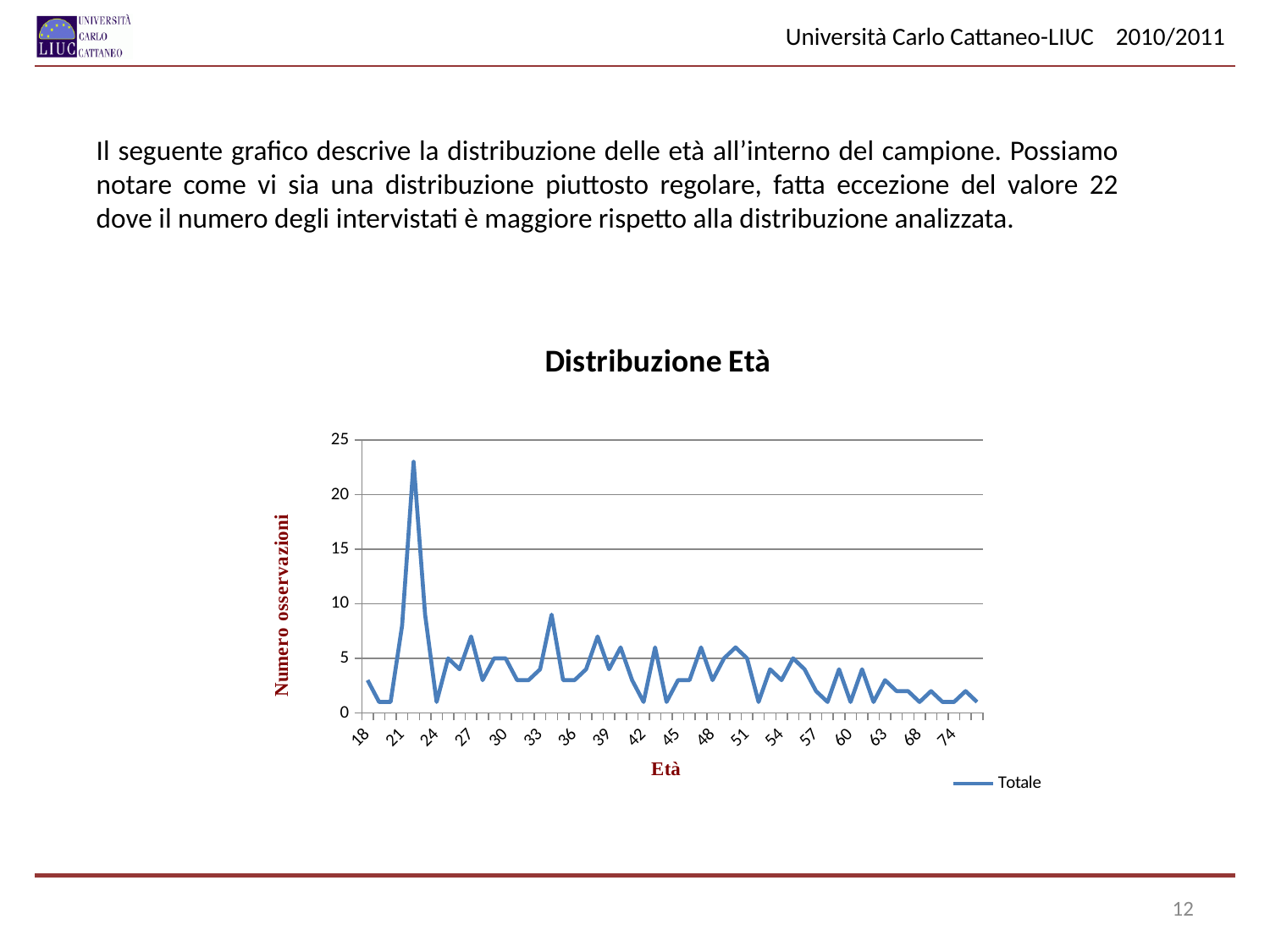
Is the value for age 24 in the "Distribuzione Età" chart greater or less than 5? less How many series does the legend of the "Distribuzione Età" chart list? 1 How many age labels are shown on the x axis of the "Distribuzione Età" chart? 18 At which age does the "Distribuzione Età" chart reach its highest number of observations? 22 In the "Distribuzione Età" chart, which age has more observations, 39 or 42? 39 Is the value for age 27 in the "Distribuzione Età" chart greater or less than 5? greater What is the title of the vertical axis in the "Distribuzione Età" chart? Numero osservazioni Is the value for age 57 in the "Distribuzione Età" chart greater or less than 5? less What kind of chart is shown under the title "Distribuzione Età"? line chart What is the name of the series shown in the legend of the "Distribuzione Età" chart? Totale